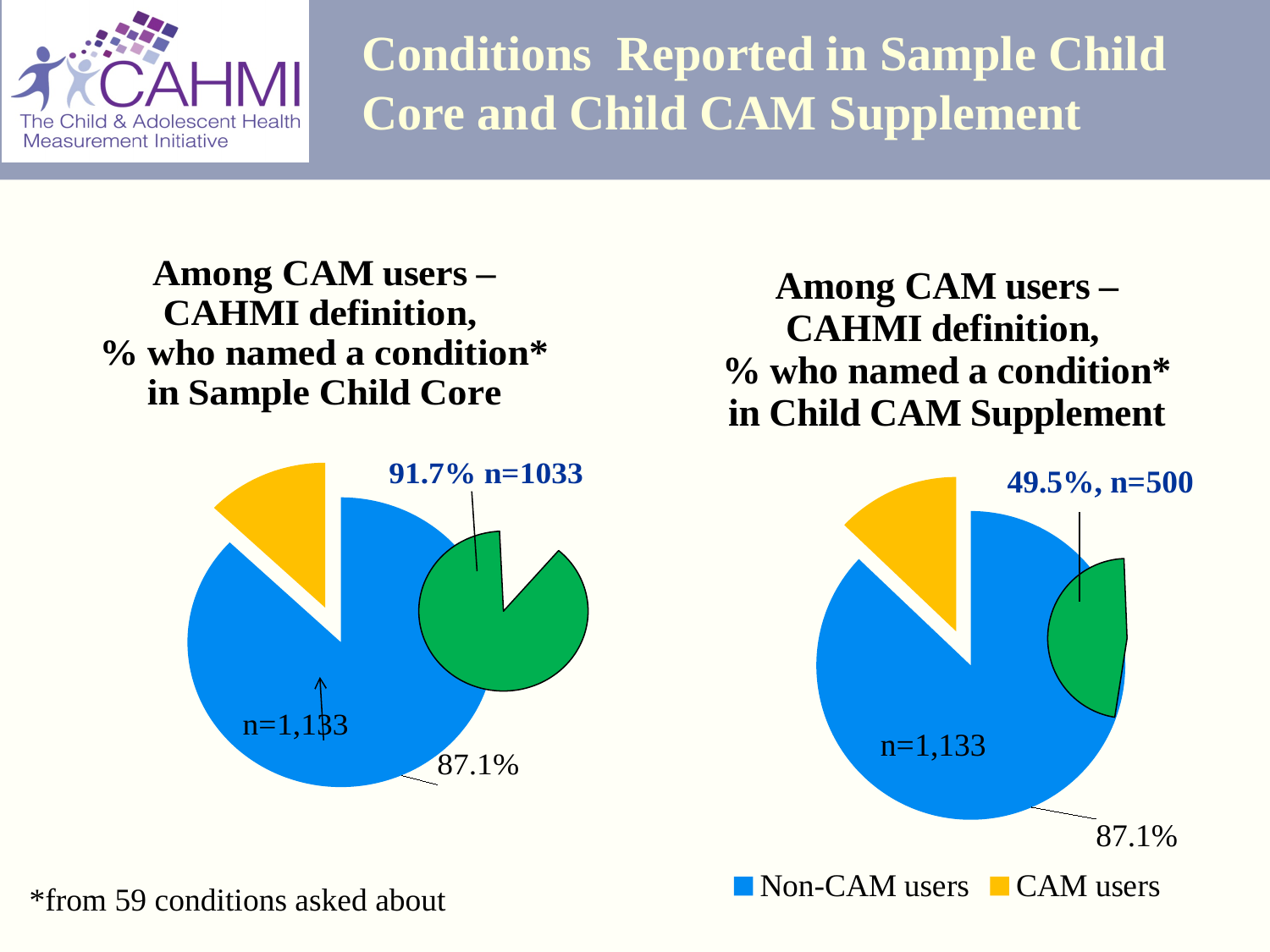
According to the footnote, how many conditions were asked about? 59 In the left chart (Sample Child Core), what is the n for CAM users who named a condition? n=1033 What kind of chart is used on this slide? Pie chart What is the difference in percentage points between the share of CAM users naming a condition in Sample Child Core (91.7%) and in Child CAM Supplement (49.5%)? 42.2 percentage points In the left chart (Sample Child Core), what percentage of CAM users named a condition? 91.7% In the right chart (Child CAM Supplement), what is the n shown for Non-CAM users? n=1,133 What colour represents CAM users in the legend? Yellow In the right chart (Child CAM Supplement), what is the n for CAM users who named a condition? n=500 In the right chart (Child CAM Supplement), what percentage of CAM users named a condition? 49.5% In the left chart (Sample Child Core), what share is labelled for Non-CAM users? 87.1% How many entries does the legend list? 2 Which chart shows a higher percentage of CAM users naming a condition, Sample Child Core or Child CAM Supplement? Sample Child Core